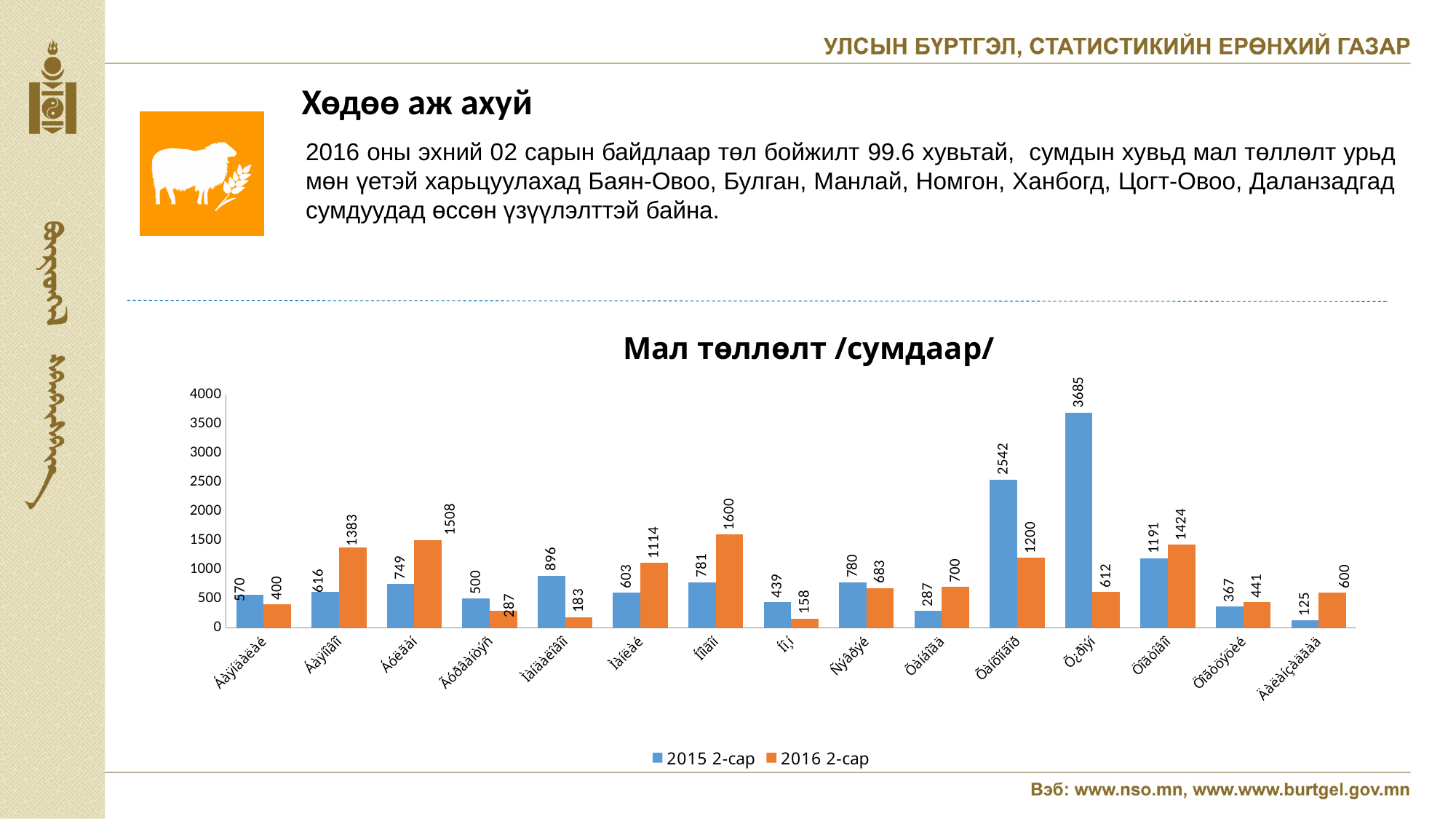
What is the highest value plotted for the 2015 2-сар series? 3685 What are the two series named in the chart legend? 2015 2-сар and 2016 2-сар What is the lowest value plotted for the 2016 2-сар series? 158 What is the lowest value plotted for the 2015 2-сар series? 125 Is the tallest bar in the chart greater or less than 3500? greater What type of chart is shown on the slide? bar chart What is the title of the chart? Мал төллөлт /сумдаар/ In the leftmost category group, what is the difference between the 2015 2-сар value and the 2016 2-сар value? 170 How many series does the chart legend list? 2 How many category groups are plotted along the x axis of the chart? 15 What is the highest value plotted for the 2016 2-сар series? 1600 In the leftmost category group, what is the value of the 2015 2-сар bar? 570